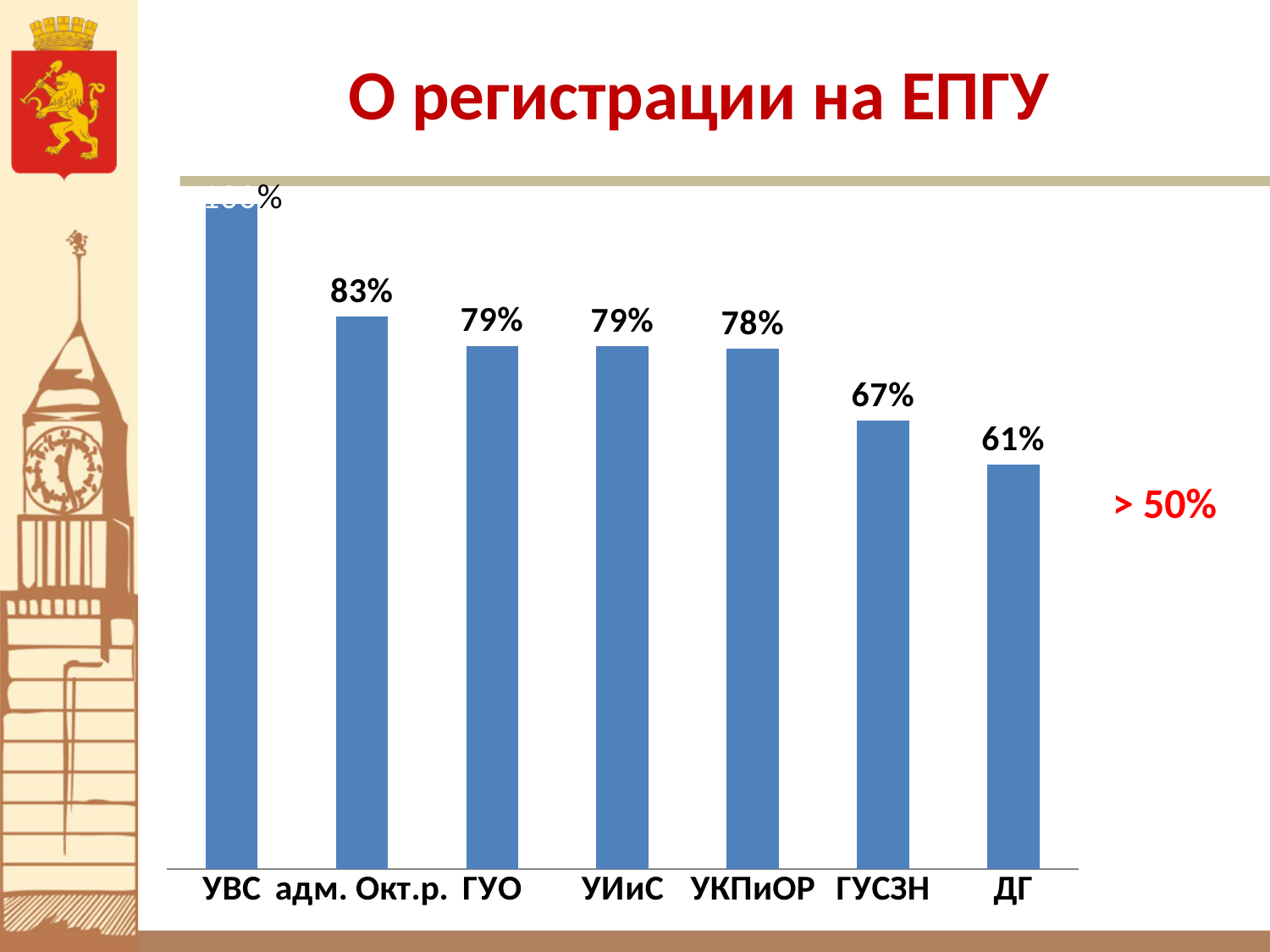
What is the value for УКПиОР? 78% What is the value for ДГ? 61% What is the value for ГУО? 79% Which is larger, the value for ГУСЗН or the value for ДГ? ГУСЗН How many categories are shown in the chart? 7 What is the difference between the values for адм. Окт.р. and ДГ? 22% What is the value for ГУСЗН? 67% What is the value for адм. Окт.р.? 83% Which category has the highest value? УВС Do the values rise or fall from left to right along the x axis? fall What kind of chart is shown on the slide? bar chart Which category has the lowest value? ДГ